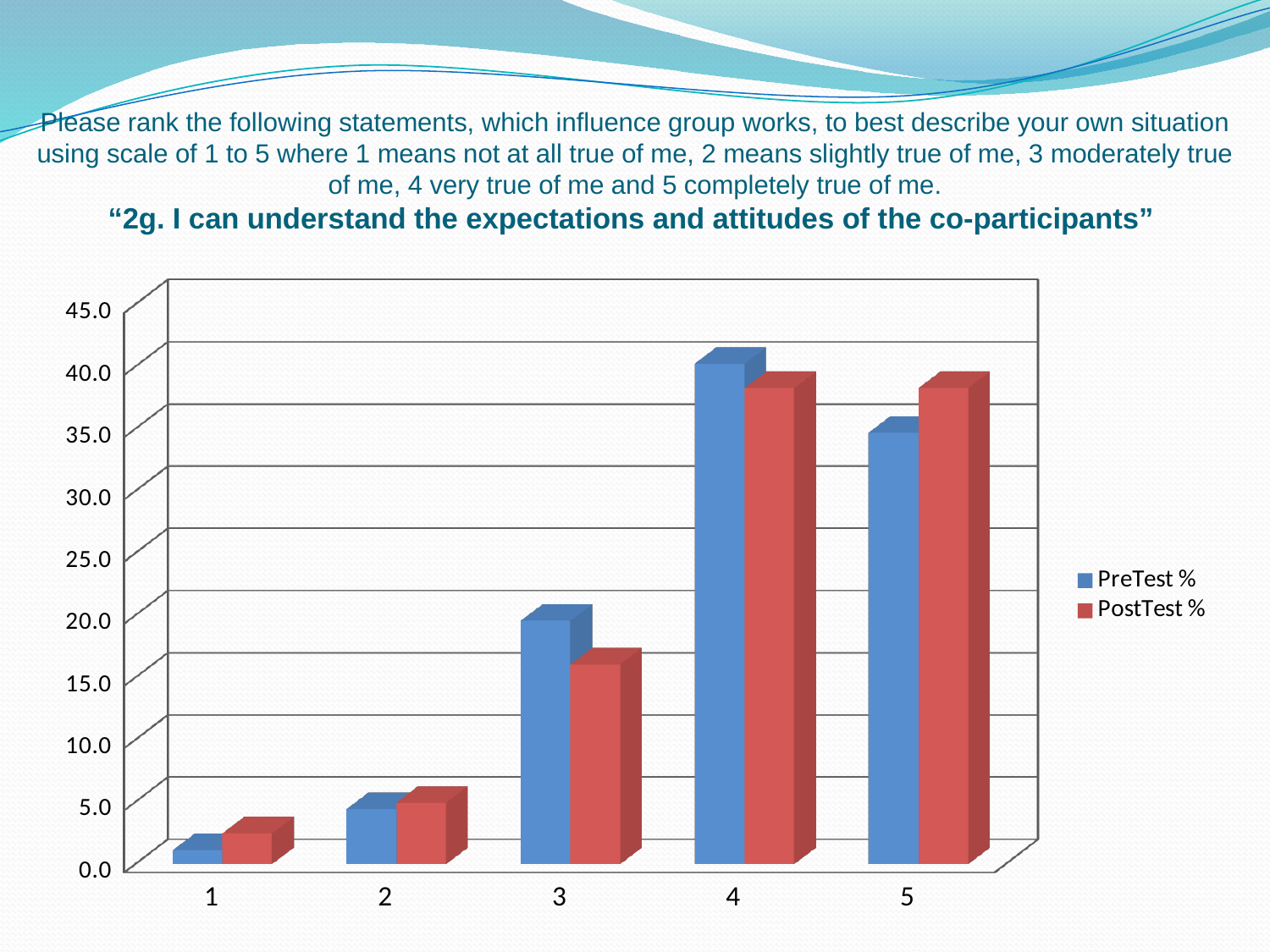
How many series does the legend list? 2 For category 5, which is larger, PreTest % or PostTest %? PostTest % Which colour represents the PostTest % series in the legend? red For category 3, which is larger, PreTest % or PostTest %? PreTest % Which category has the highest PreTest % value? 4 What kind of chart is shown on the slide? bar chart Which category has the lowest PostTest % value? 1 Which category has the lowest PreTest % value? 1 Do the PreTest % values rise or fall from category 1 to category 4? rise Is the PreTest % value for category 5 greater or less than 40.0? less How many categories are shown on the x axis? 5 Is the PostTest % value for category 3 greater or less than 20.0? less